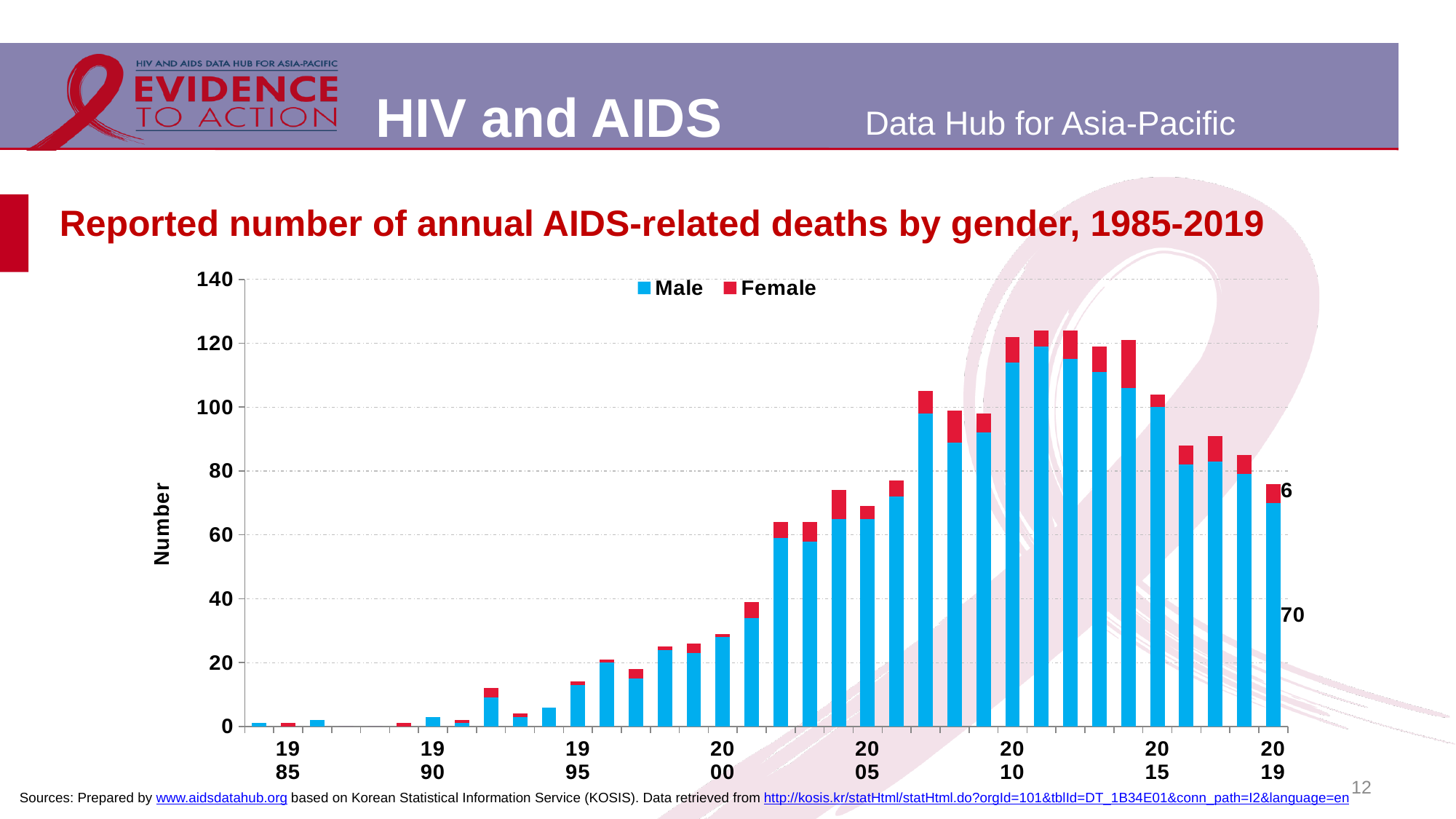
Is the male value for 2010 greater or less than 100? greater What is the total number of AIDS-related deaths (male plus female) reported in 2019? 76 What is the number of female AIDS-related deaths reported in 2019? 6 Is the male value for 2005 greater or less than 80? less What is the label on the vertical axis of the chart? Number What kind of chart is shown on the slide? bar chart How many series does the legend list? 2 Between 2013 and 2019, do the total bars generally rise or fall? fall What is the number of male AIDS-related deaths reported in 2019? 70 Which colour represents the Female series in the chart? red In 2019, which gender has the larger number of reported AIDS-related deaths? Male Is the total bar for 2000 greater or less than 40? less